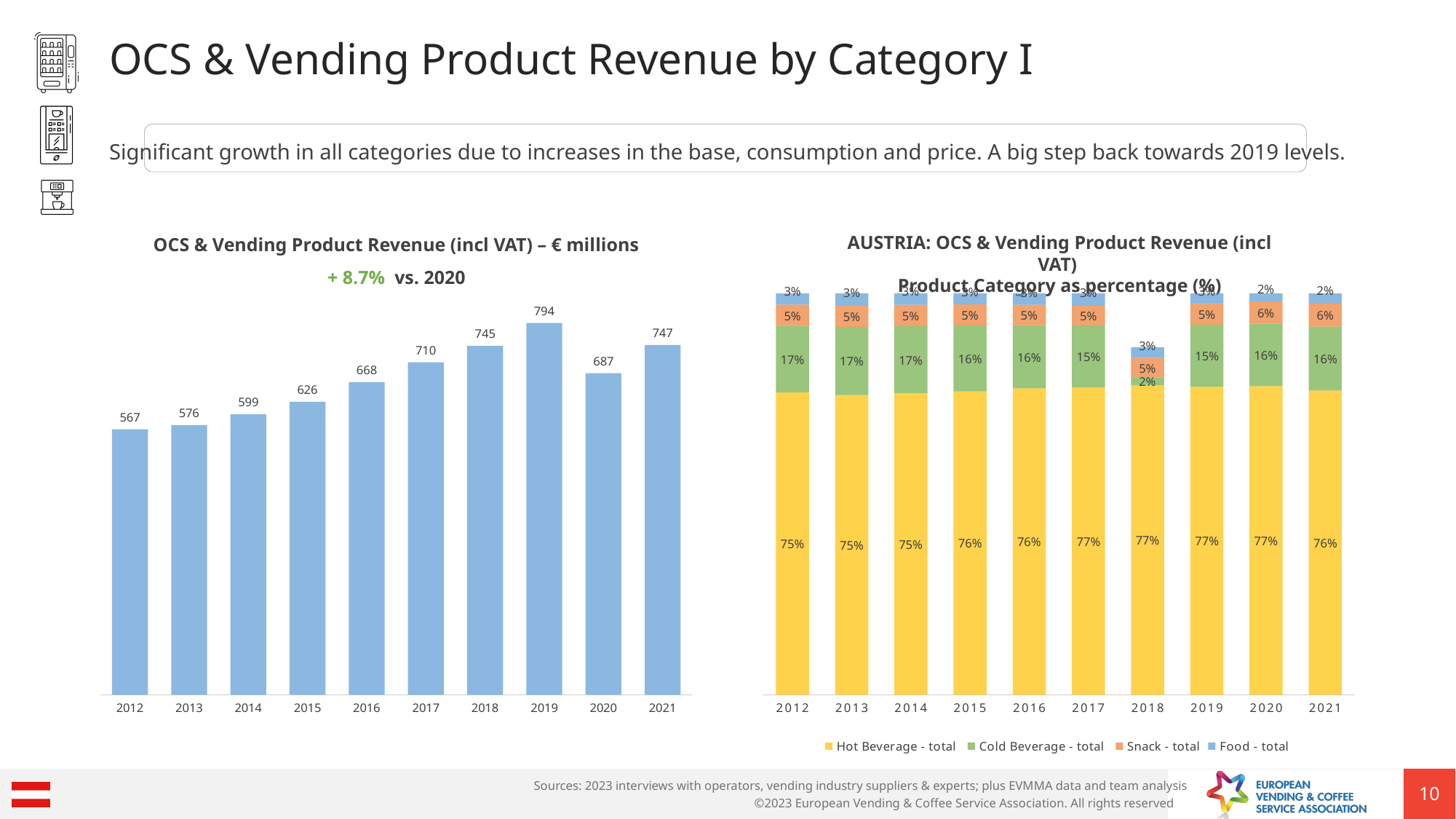
In the left chart, OCS & Vending Product Revenue (incl VAT) – € millions, what is the value for 2019? 794 In the right chart, AUSTRIA: OCS & Vending Product Revenue Product Category as percentage, how many series does the legend list? 4 In the left chart, OCS & Vending Product Revenue (incl VAT) – € millions, what is the difference between the 2021 and 2020 values? 60 What kind of chart is the right chart, AUSTRIA: OCS & Vending Product Revenue Product Category as percentage? Stacked bar chart In the left chart, OCS & Vending Product Revenue (incl VAT) – € millions, what is the value for 2021? 747 In the left chart, OCS & Vending Product Revenue (incl VAT) – € millions, which is larger, the value for 2018 or the value for 2021? 2021 In the right chart, AUSTRIA: OCS & Vending Product Revenue Product Category as percentage, what is the Snack - total share for 2020? 6% In the left chart, OCS & Vending Product Revenue (incl VAT) – € millions, what percentage growth vs. 2020 is stated above the chart? + 8.7% In the left chart, OCS & Vending Product Revenue (incl VAT) – € millions, which year has the lowest value? 2012 In the left chart, OCS & Vending Product Revenue (incl VAT) – € millions, which year has the highest value? 2019 In the left chart, OCS & Vending Product Revenue (incl VAT) – € millions, how many years are shown? 10 In the right chart, AUSTRIA: OCS & Vending Product Revenue Product Category as percentage, what is the Hot Beverage - total share for 2021? 76%